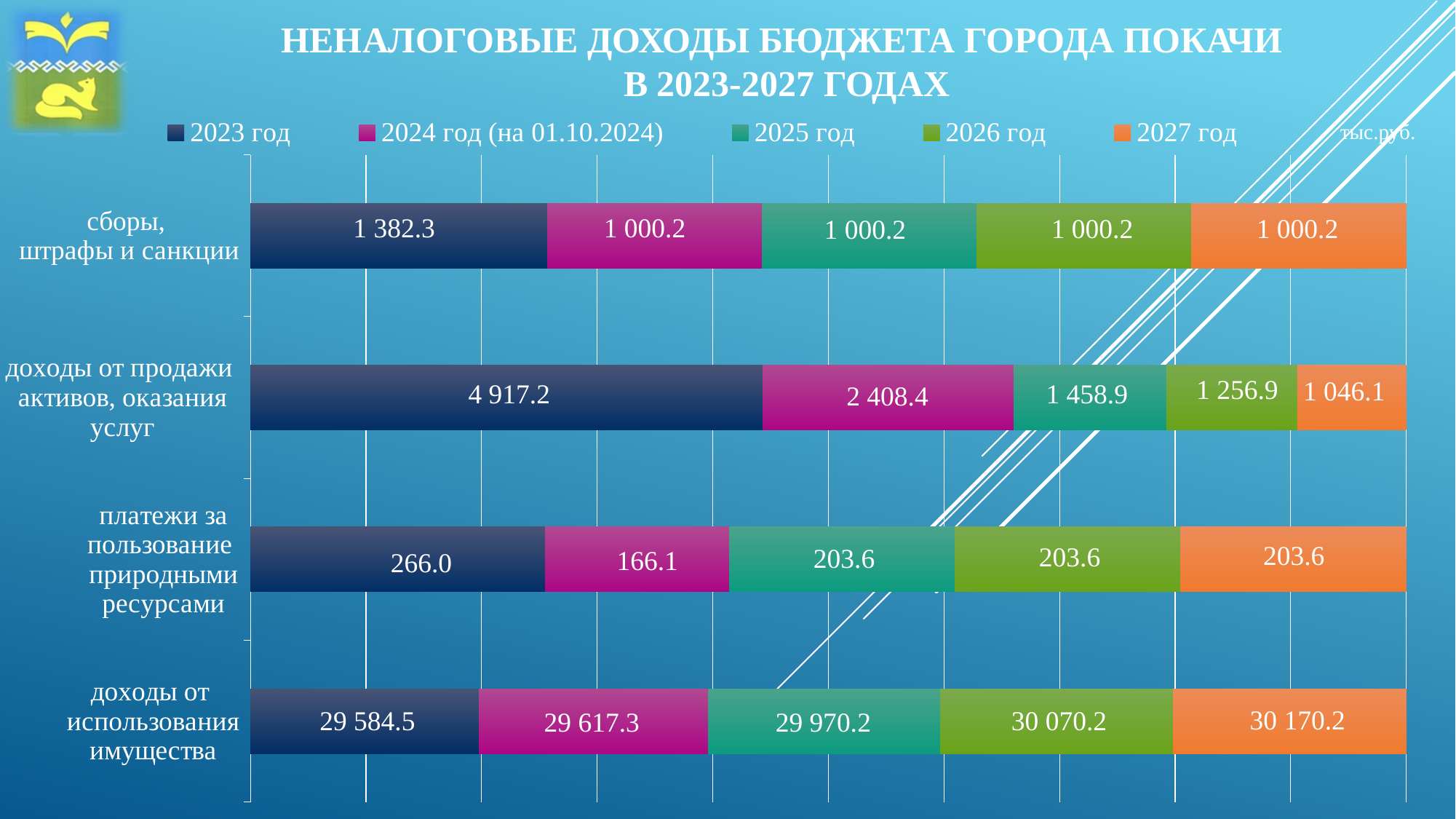
How many categories (bars) does the chart show? 4 What is the value for 2025 год in the 'доходы от продажи активов, оказания услуг' bar? 1 458.9 What is the value for 2027 год in the 'доходы от использования имущества' bar? 30 170.2 Which is larger for 'платежи за пользование природными ресурсами': the 2023 год value or the 2025 год value? 2023 год What kind of chart is shown on the slide? Stacked bar chart How many series does the legend list? 5 In the 'доходы от использования имущества' bar, which year has the lowest value? 2023 год What is the difference between the 2023 год and 2024 год values for 'доходы от продажи активов, оказания услуг'? 2 508.8 What is the value for 2024 год (на 01.10.2024) in the 'платежи за пользование природными ресурсами' bar? 166.1 Do the values for 'доходы от использования имущества' rise or fall from 2023 год to 2027 год? Rise In the 'доходы от продажи активов, оказания услуг' bar, which year has the highest value? 2023 год What is the value for 2023 год in the 'сборы, штрафы и санкции' bar? 1 382.3